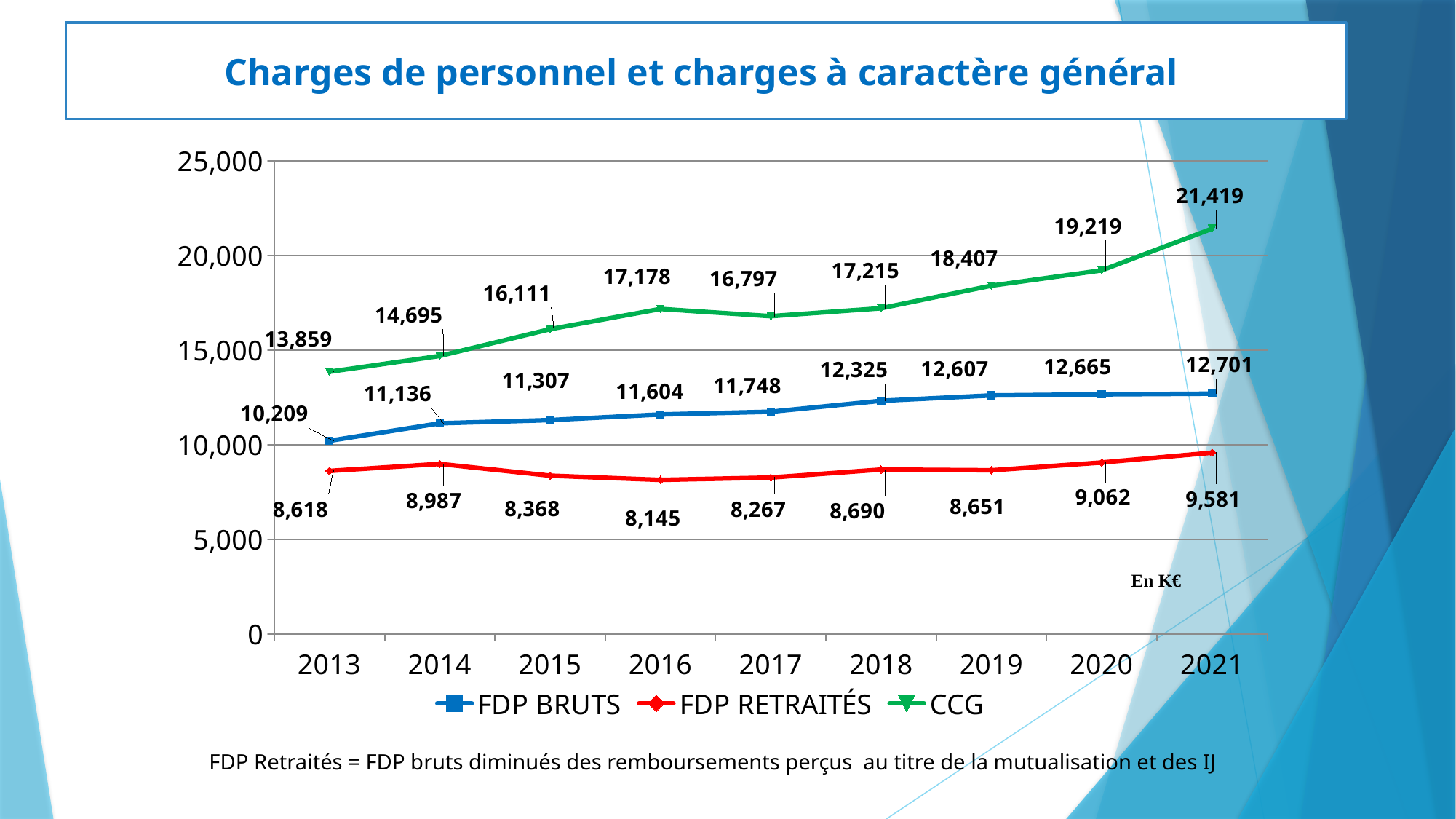
What kind of chart is shown on the slide? line chart What is the FDP BRUTS value for 2013? 10,209 What is the CCG value for 2021? 21,419 What is the FDP RETRAITÉS value for 2016? 8,145 In which year is the CCG value highest? 2021 In which year is the FDP RETRAITÉS value lowest? 2016 Does the FDP BRUTS series rise or fall from 2013 to 2021? rise What is the difference between the CCG value and the FDP BRUTS value in 2021? 8,718 Which is larger in 2017: the CCG value or the FDP BRUTS value? CCG How many series does the legend list? 3 Is the FDP RETRAITÉS value for 2021 greater or less than 10,000? less How many years are shown on the x axis? 9